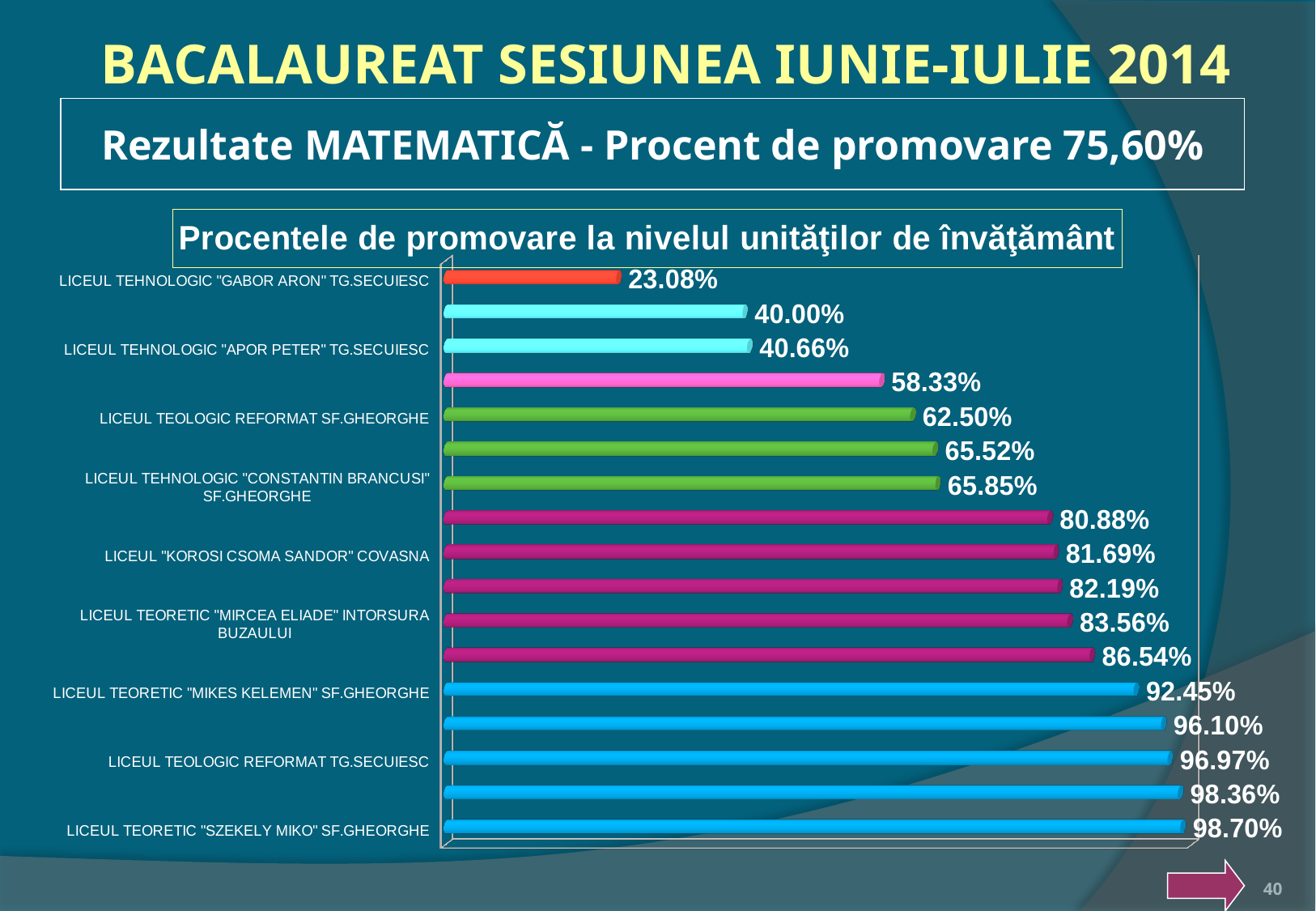
What is the pass rate shown for LICEUL TEORETIC "SZEKELY MIKO" SF.GHEORGHE? 98.70% Which school has the lowest pass rate in the chart? LICEUL TEHNOLOGIC "GABOR ARON" TG.SECUIESC How many bars are plotted in the chart? 17 Which school has the highest pass rate in the chart? LICEUL TEORETIC "SZEKELY MIKO" SF.GHEORGHE What is the difference in pass rate between LICEUL TEORETIC "SZEKELY MIKO" SF.GHEORGHE and LICEUL TEHNOLOGIC "GABOR ARON" TG.SECUIESC? 75.62% What is the pass rate shown for LICEUL TEORETIC "MIKES KELEMEN" SF.GHEORGHE? 92.45% What is the pass rate shown for LICEUL TEHNOLOGIC "CONSTANTIN BRANCUSI" SF.GHEORGHE? 65.85% Which has the higher pass rate: LICEUL TEOLOGIC REFORMAT TG.SECUIESC or LICEUL TEOLOGIC REFORMAT SF.GHEORGHE? LICEUL TEOLOGIC REFORMAT TG.SECUIESC What is the pass rate shown for LICEUL "KOROSI CSOMA SANDOR" COVASNA? 81.69% What is the title of the chart? Procentele de promovare la nivelul unităţilor de învăţământ What is the pass rate shown for LICEUL TEHNOLOGIC "GABOR ARON" TG.SECUIESC? 23.08% What type of chart is shown on the slide? Bar chart